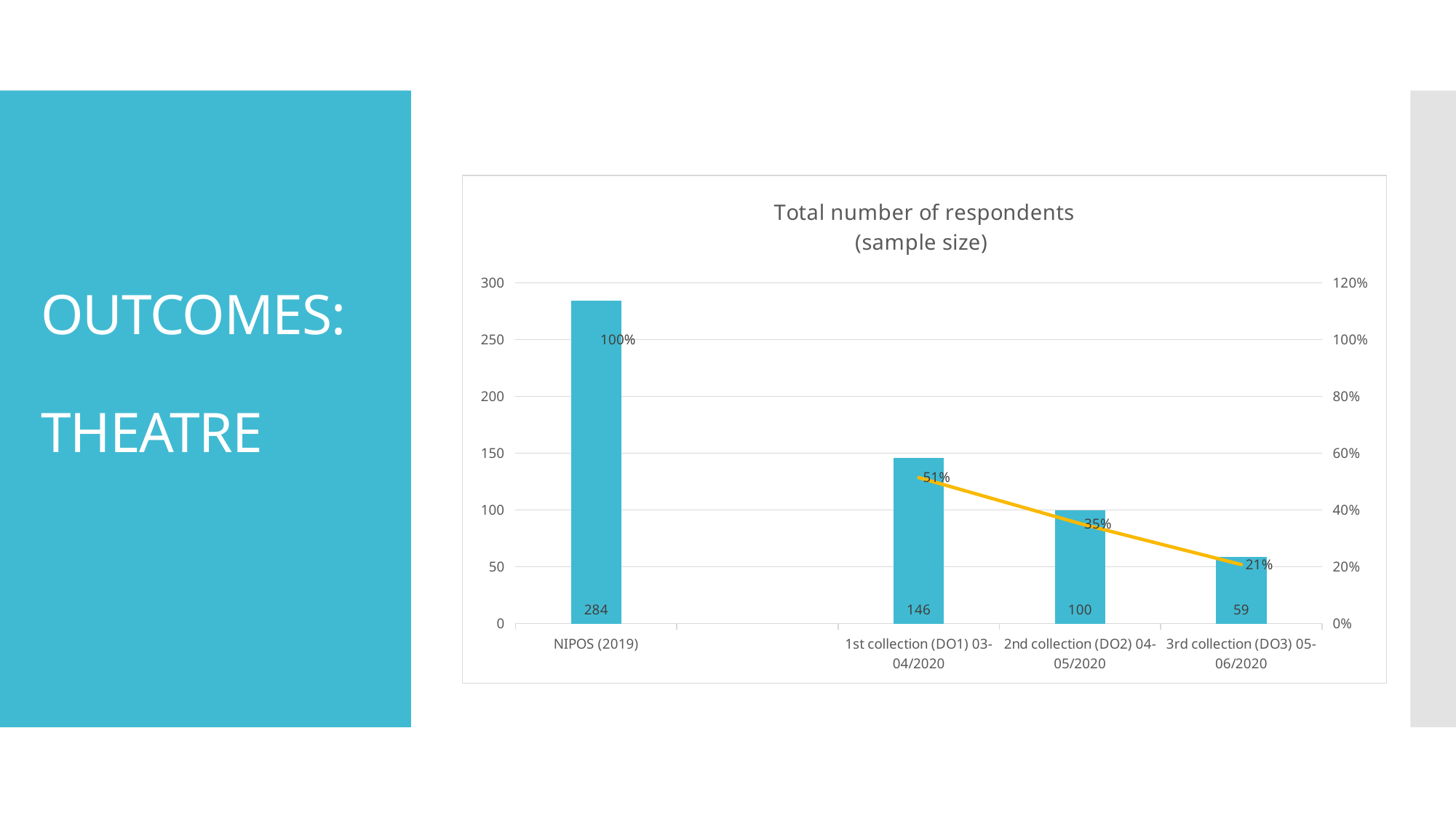
Which category has the highest number of respondents? NIPOS (2019) What is the title of the chart? Total number of respondents (sample size) What is the total number of respondents for NIPOS (2019)? 284 What is the total number of respondents for the 1st collection (DO1) 03-04/2020? 146 Which category has the lowest number of respondents? 3rd collection (DO3) 05-06/2020 What is the difference in respondents between NIPOS (2019) and the 1st collection (DO1) 03-04/2020? 138 Do the number of respondents rise or fall from left to right across the categories? fall Which has more respondents, the 2nd collection (DO2) 04-05/2020 or the 3rd collection (DO3) 05-06/2020? 2nd collection (DO2) 04-05/2020 What percentage is shown for the 2nd collection (DO2) 04-05/2020? 35% What is the difference between the percentage for the 1st collection (DO1) and the 3rd collection (DO3)? 30% How many categories are shown on the x axis? 4 What is the total number of respondents for the 3rd collection (DO3) 05-06/2020? 59